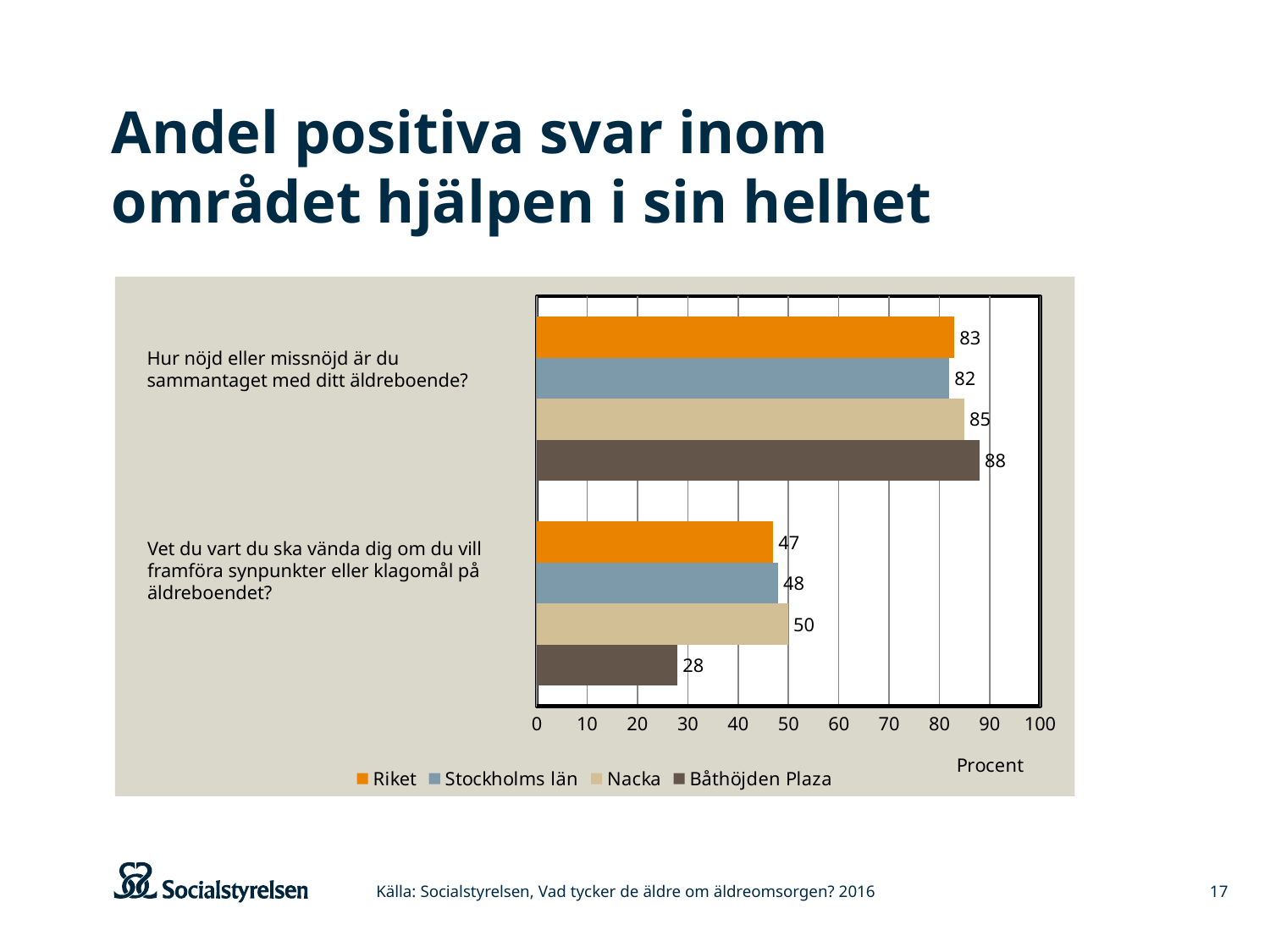
What is the value for Riket for the question 'Vet du vart du ska vända dig om du vill framföra synpunkter eller klagomål på äldreboendet?' 47 What is the value for Båthöjden Plaza for the question 'Hur nöjd eller missnöjd är du sammantaget med ditt äldreboende?' 88 What is the value for Nacka for the question 'Hur nöjd eller missnöjd är du sammantaget med ditt äldreboende?' 85 What is the difference between the Nacka value and the Båthöjden Plaza value for the question 'Vet du vart du ska vända dig om du vill framföra synpunkter eller klagomål på äldreboendet?' 22 What unit is shown on the x axis of the chart? Procent For the question 'Hur nöjd eller missnöjd är du sammantaget med ditt äldreboende?', which is larger: the value for Riket or the value for Stockholms län? Riket What type of chart is shown on the slide? bar chart Which series has the highest value for the question 'Hur nöjd eller missnöjd är du sammantaget med ditt äldreboende?' Båthöjden Plaza Which series has the lowest value for the question 'Vet du vart du ska vända dig om du vill framföra synpunkter eller klagomål på äldreboendet?' Båthöjden Plaza How many survey questions (categories) are shown on the chart? 2 How many series does the legend list? 4 What is the value for Stockholms län for the question 'Vet du vart du ska vända dig om du vill framföra synpunkter eller klagomål på äldreboendet?' 48